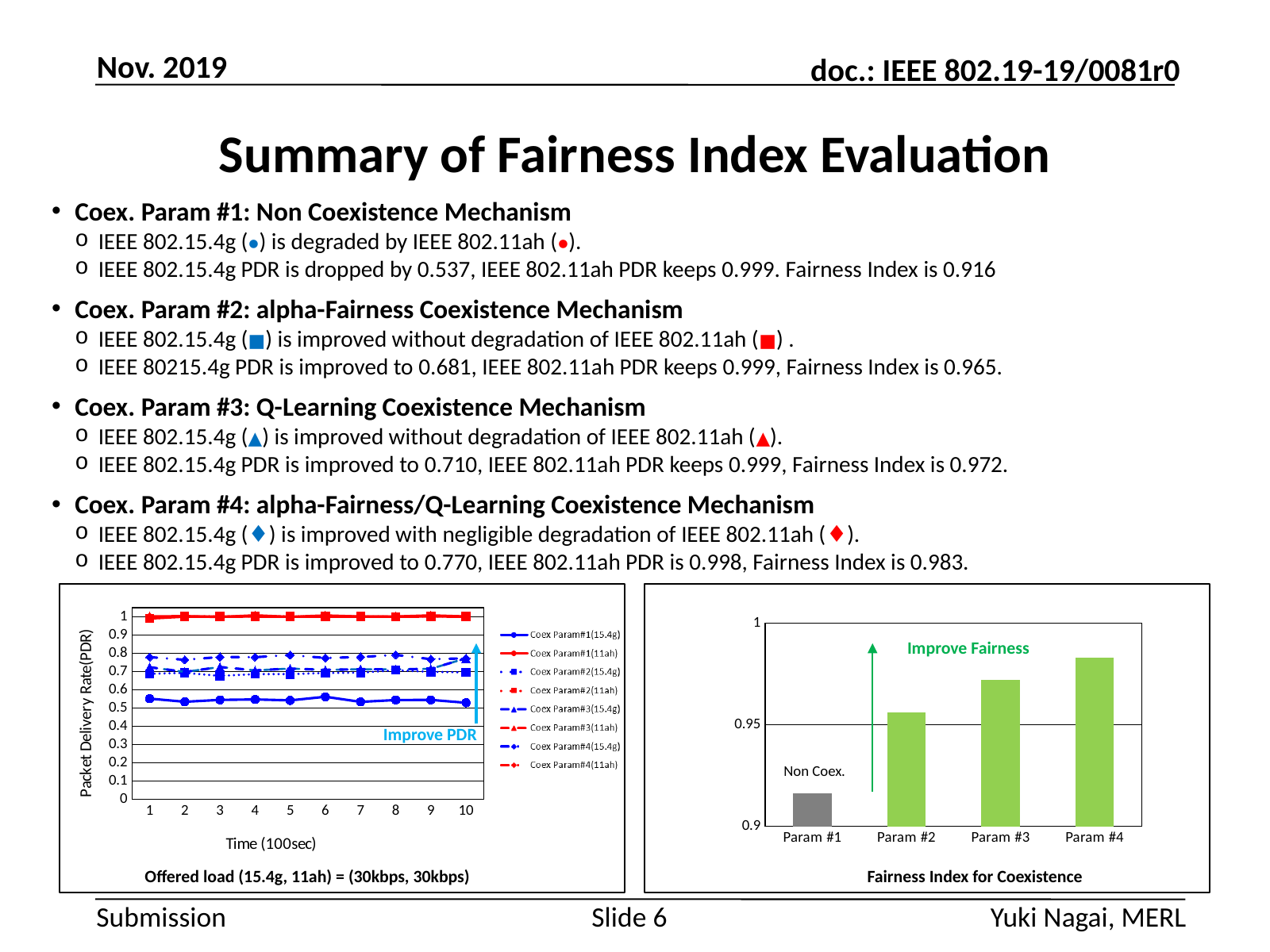
In the 'Fairness Index for Coexistence' chart, which category has the highest bar? Param #4 What kind of chart is the chart on the left of the slide showing Packet Delivery Rate? line chart In the 'Fairness Index for Coexistence' chart, is the value for Param #3 greater or less than 0.95? greater In the 'Fairness Index for Coexistence' chart, which category has the lowest bar? Param #1 In the 'Fairness Index for Coexistence' chart, do the bar values rise or fall from Param #1 to Param #4? rise In the Packet Delivery Rate line chart on the left, how many points are shown along the Time axis? 10 What kind of chart is the chart on the right of the slide, titled 'Fairness Index for Coexistence'? bar chart In the 'Fairness Index for Coexistence' chart, how many categories are shown on the x axis? 4 In the Packet Delivery Rate line chart on the left, is the value for Coex Param#1(15.4g) at time 1 greater or less than 0.6? less In the 'Fairness Index for Coexistence' chart, which is larger, the value for Param #2 or the value for Param #4? Param #4 In the Packet Delivery Rate line chart on the left, how many series does the legend list? 8 In the 'Fairness Index for Coexistence' chart, is the value for Param #1 greater or less than 0.95? less